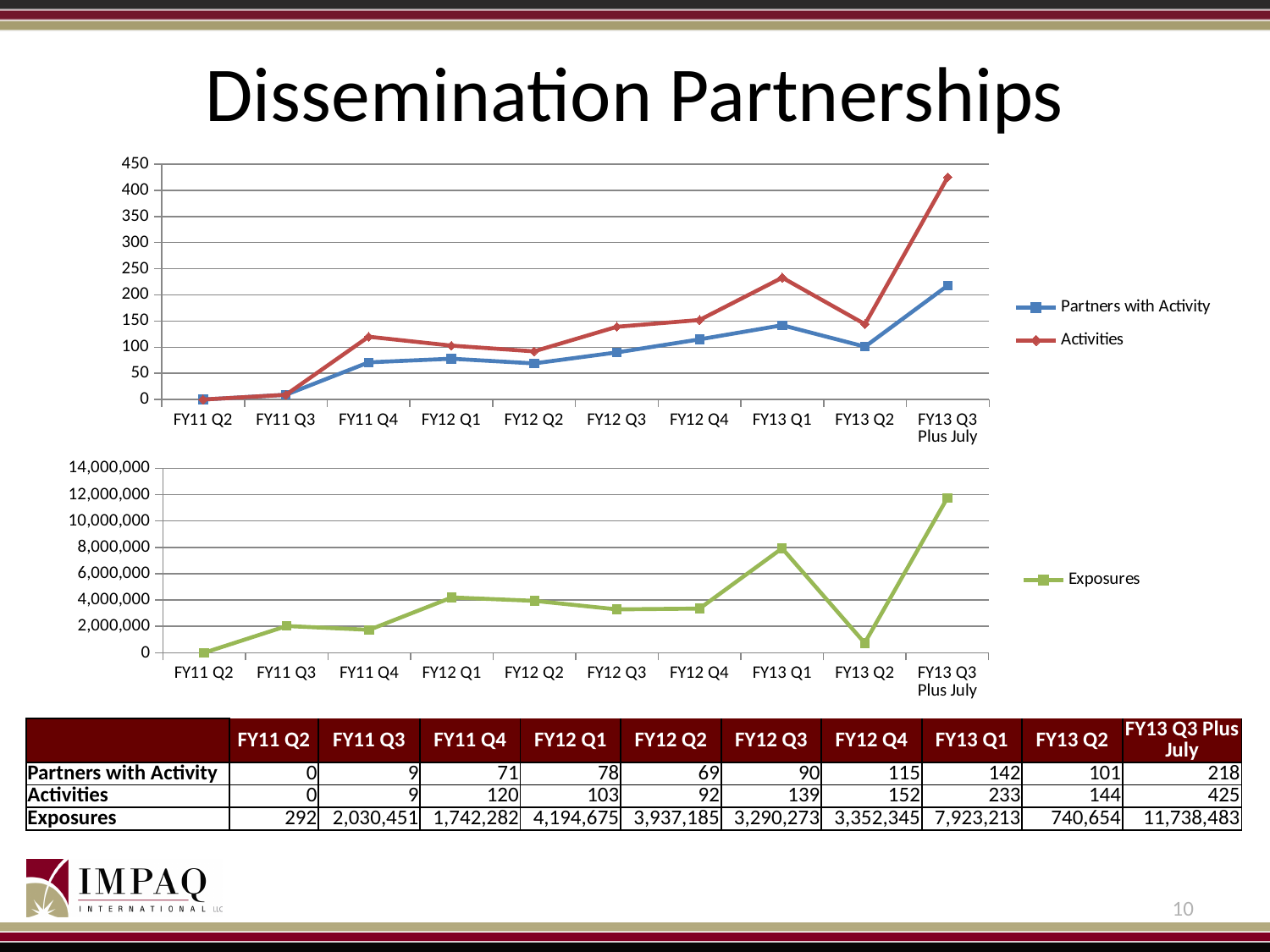
How many series does the legend of the top chart list? 2 How many periods are plotted along the x axis of the bottom chart? 10 In the top chart, which period has the highest value for Partners with Activity? FY13 Q3 Plus July In the top chart, what is the value of Activities for FY13 Q1? 233 In the bottom chart, which period has the lowest value for Exposures? FY11 Q2 What kind of chart is the top chart on the slide? line chart In the top chart, is the value of Activities for FY13 Q3 Plus July greater or less than 400? greater What is the name of the series shown in the legend of the bottom chart? Exposures In the bottom chart, which period has the larger Exposures value, FY12 Q1 or FY12 Q2? FY12 Q1 In the bottom chart, what is the value of Exposures for FY13 Q3 Plus July? 11,738,483 In the bottom chart, do Exposures rise or fall from FY13 Q1 to FY13 Q2? fall In the top chart, what is the difference between Activities and Partners with Activity for FY13 Q3 Plus July? 207